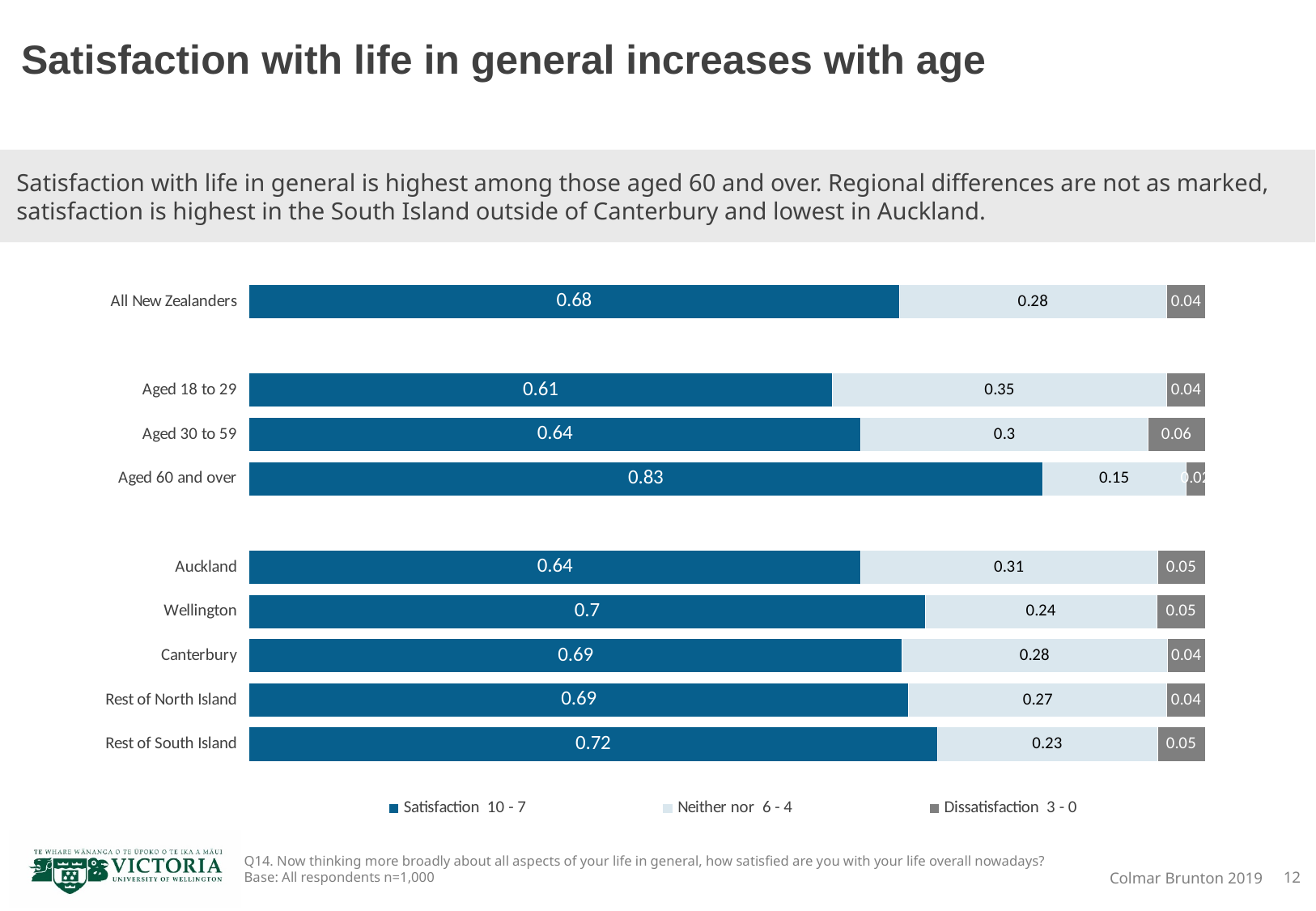
How many categories are shown in the chart? 9 Which category has the lowest Satisfaction 10 - 7 value? Aged 18 to 29 What is the Dissatisfaction 3 - 0 value for Aged 30 to 59? 0.06 How many series does the legend list? 3 What is the Neither nor 6 - 4 value for Wellington? 0.24 What is the Neither nor 6 - 4 value for Aged 18 to 29? 0.35 What is the difference between the Satisfaction 10 - 7 values for Aged 60 and over and Aged 18 to 29? 0.22 What is the Satisfaction 10 - 7 value for Rest of South Island? 0.72 What kind of chart is shown on the slide? Stacked bar chart Which category has the highest Satisfaction 10 - 7 value? Aged 60 and over Which has a larger Satisfaction 10 - 7 value, Wellington or Auckland? Wellington What is the Satisfaction 10 - 7 value for Aged 60 and over? 0.83